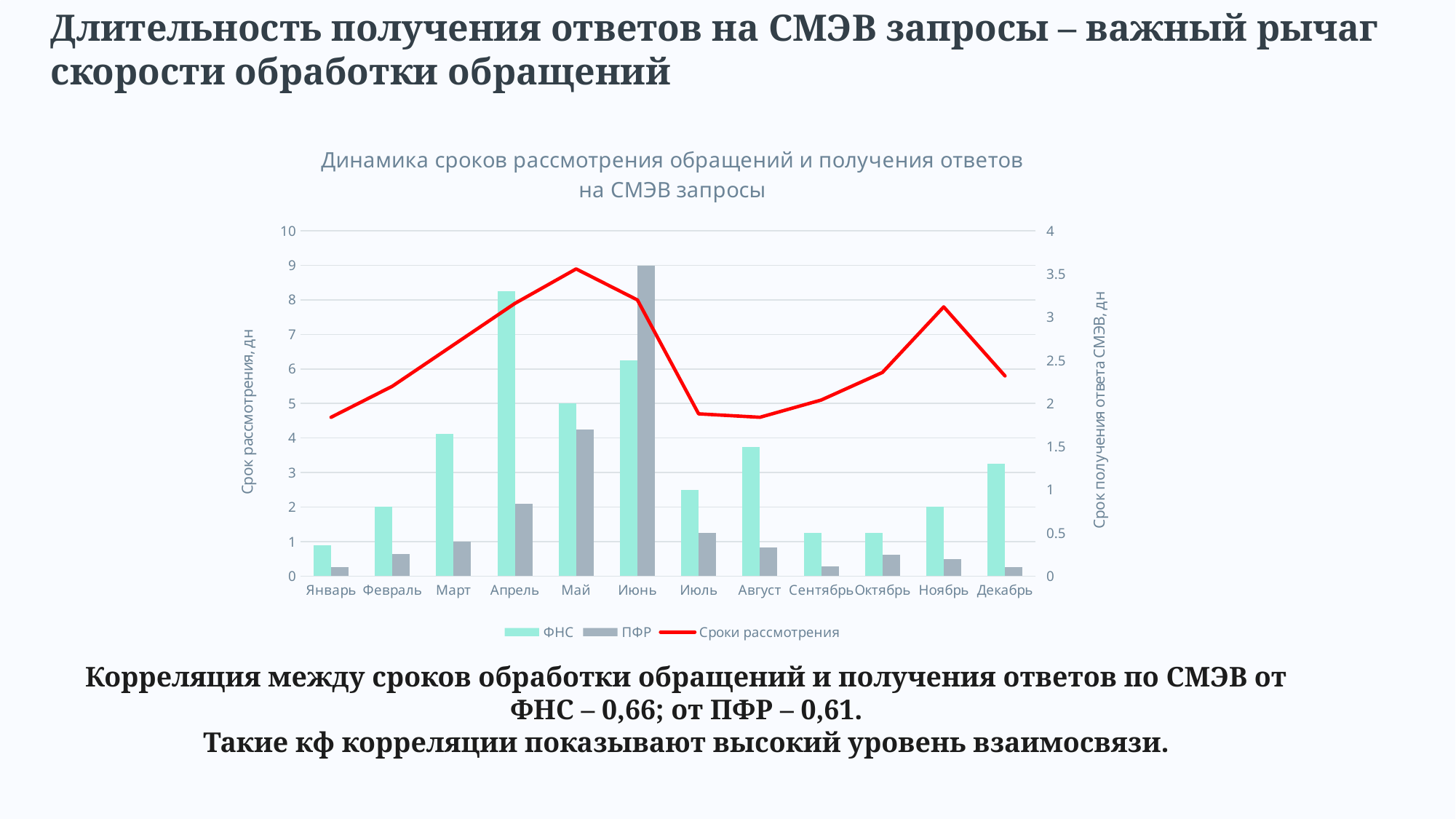
How many series does the legend list? 3 In Июнь, which is larger: the ФНС bar or the ПФР bar? ПФР What kind of chart is shown on the slide? Combined bar and line chart In which month is the ПФР bar the highest? Июнь How many months are shown on the x axis? 12 In which month is the ФНС bar the lowest? Январь Is the ПФР value for Май greater or less than 5? less In which month is the ФНС bar the highest? Апрель In which month does the Сроки рассмотрения line reach its peak? Май